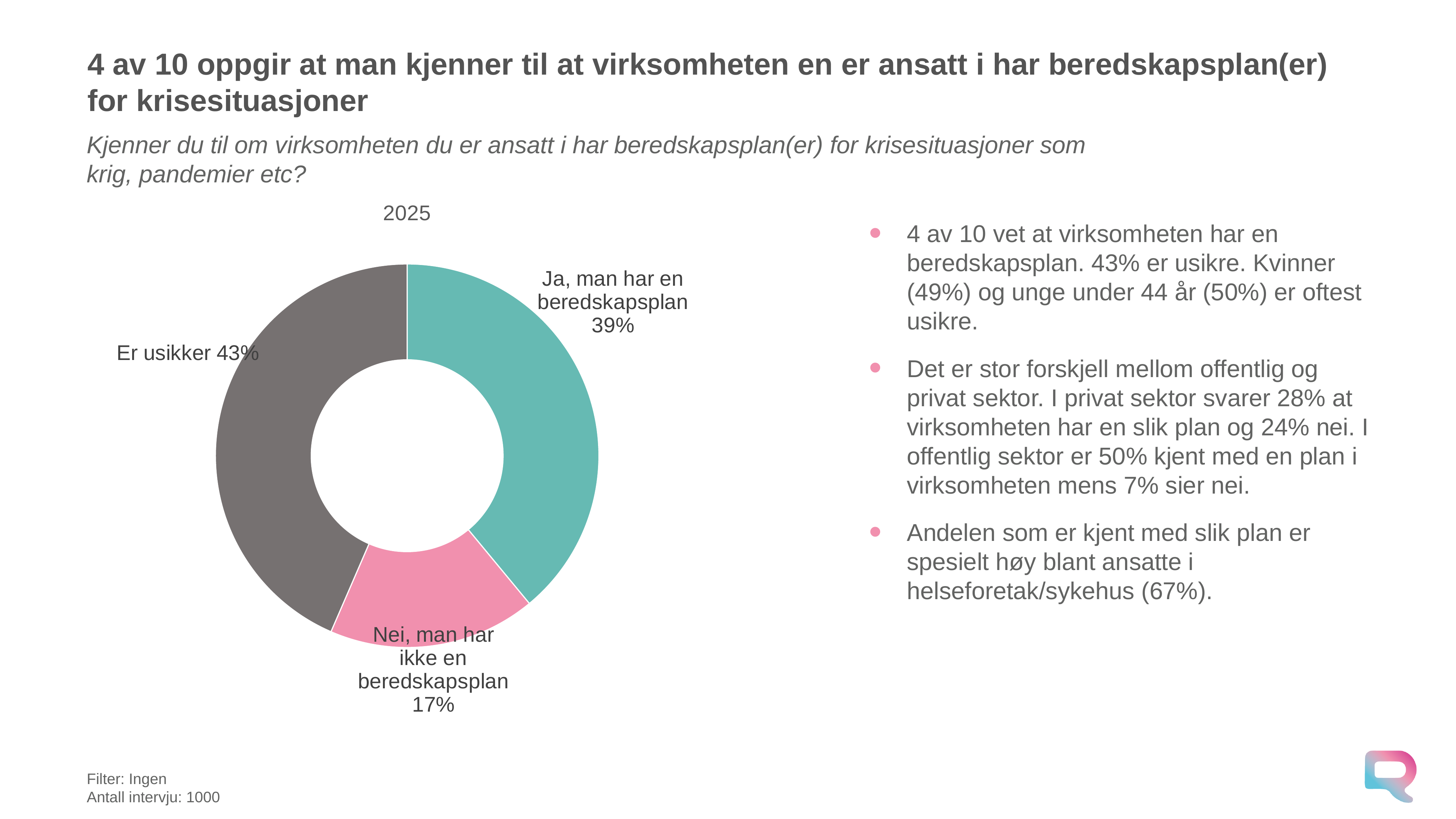
What percentage of respondents answered "Nei, man har ikke en beredskapsplan"? 17% What is the difference in percentage points between "Ja, man har en beredskapsplan" and "Nei, man har ikke en beredskapsplan"? 22 percentage points What kind of chart is shown on the slide? Pie chart (donut) Which is larger: the share for "Ja, man har en beredskapsplan" or the share for "Nei, man har ikke en beredskapsplan"? Ja, man har en beredskapsplan What percentage of respondents answered "Ja, man har en beredskapsplan"? 39% What year is shown as the chart's title? 2025 What percentage of respondents answered "Er usikker"? 43% Which response category has the smallest share of the chart? Nei, man har ikke en beredskapsplan How many response categories are shown in the chart? 3 Which response category has the largest share of the chart? Er usikker What colour is the "Er usikker" slice of the chart? Grey What is the difference in percentage points between "Er usikker" and "Ja, man har en beredskapsplan"? 4 percentage points